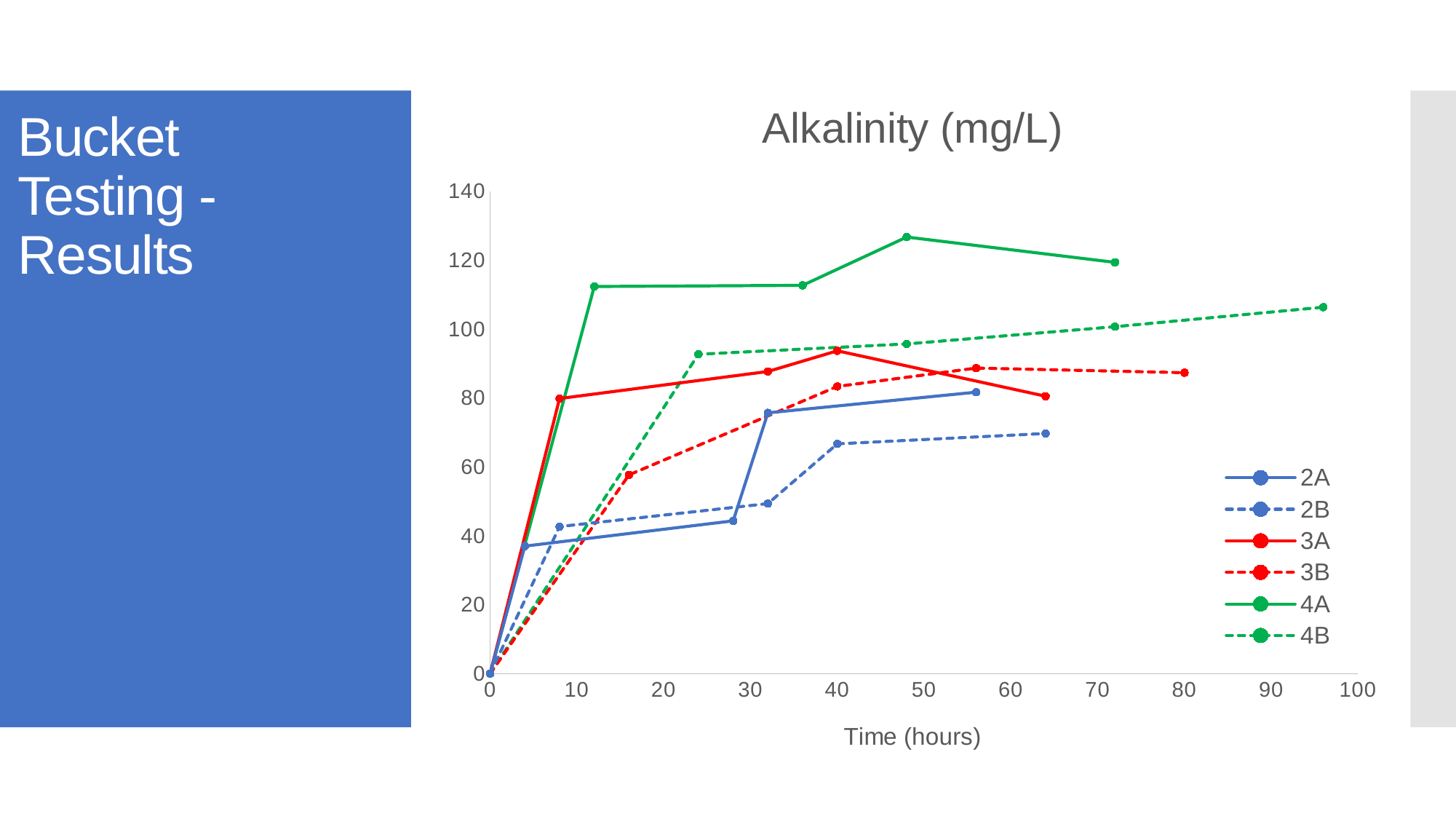
How many data points are plotted for series 4B? 6 How many series does the legend list? 6 Is the value of series 4A at about 12 hours greater or less than 100? greater What kind of chart is shown on the slide? line chart Does series 4B generally rise or fall as time increases? rise Is the final value of series 2B (at about 64 hours) greater or less than 80? less Which series reaches the highest alkalinity value on the chart? 4A What is the label of the x axis? Time (hours) What is the title of the chart? Alkalinity (mg/L) At about 40 hours, which series has the larger value, 3A or 2B? 3A Is the peak value of series 4A greater or less than 120? greater